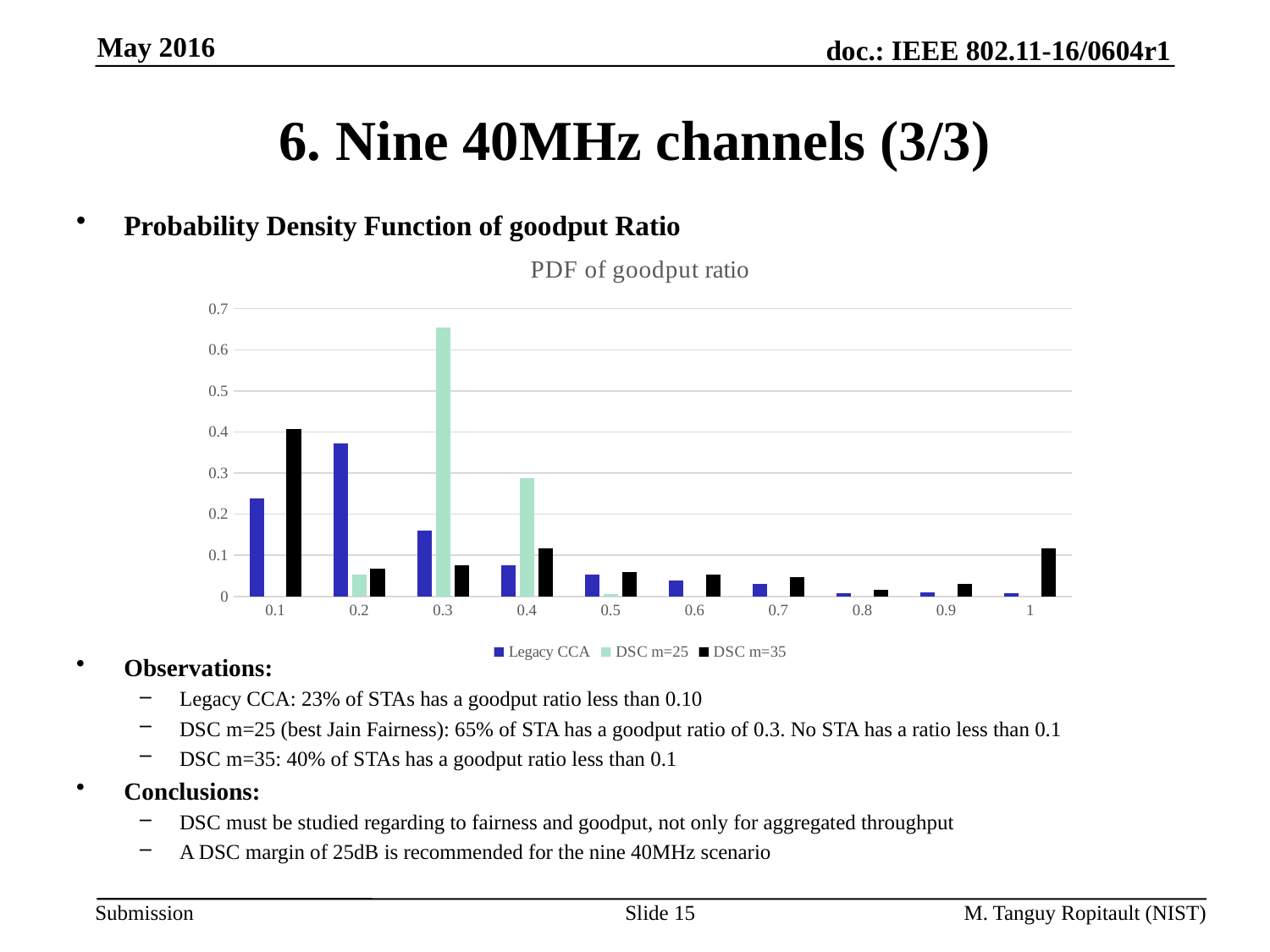
At which goodput ratio does the DSC m=25 series reach its highest value? 0.3 Which series has the tallest bar in the whole chart? DSC m=25 At goodput ratio 0.1, which is larger: Legacy CCA or DSC m=35? DSC m=35 How many goodput ratio categories are shown on the x axis? 10 How many series does the chart legend list? 3 What kind of chart is shown on the slide? bar chart Is the value for DSC m=25 at goodput ratio 0.3 greater or less than 0.6? greater At which goodput ratio does the Legacy CCA series reach its highest value? 0.2 At goodput ratio 0.2, which is larger: Legacy CCA or DSC m=35? Legacy CCA What is the title of the chart? PDF of goodput ratio Is the value for Legacy CCA at goodput ratio 0.1 greater or less than 0.2? greater